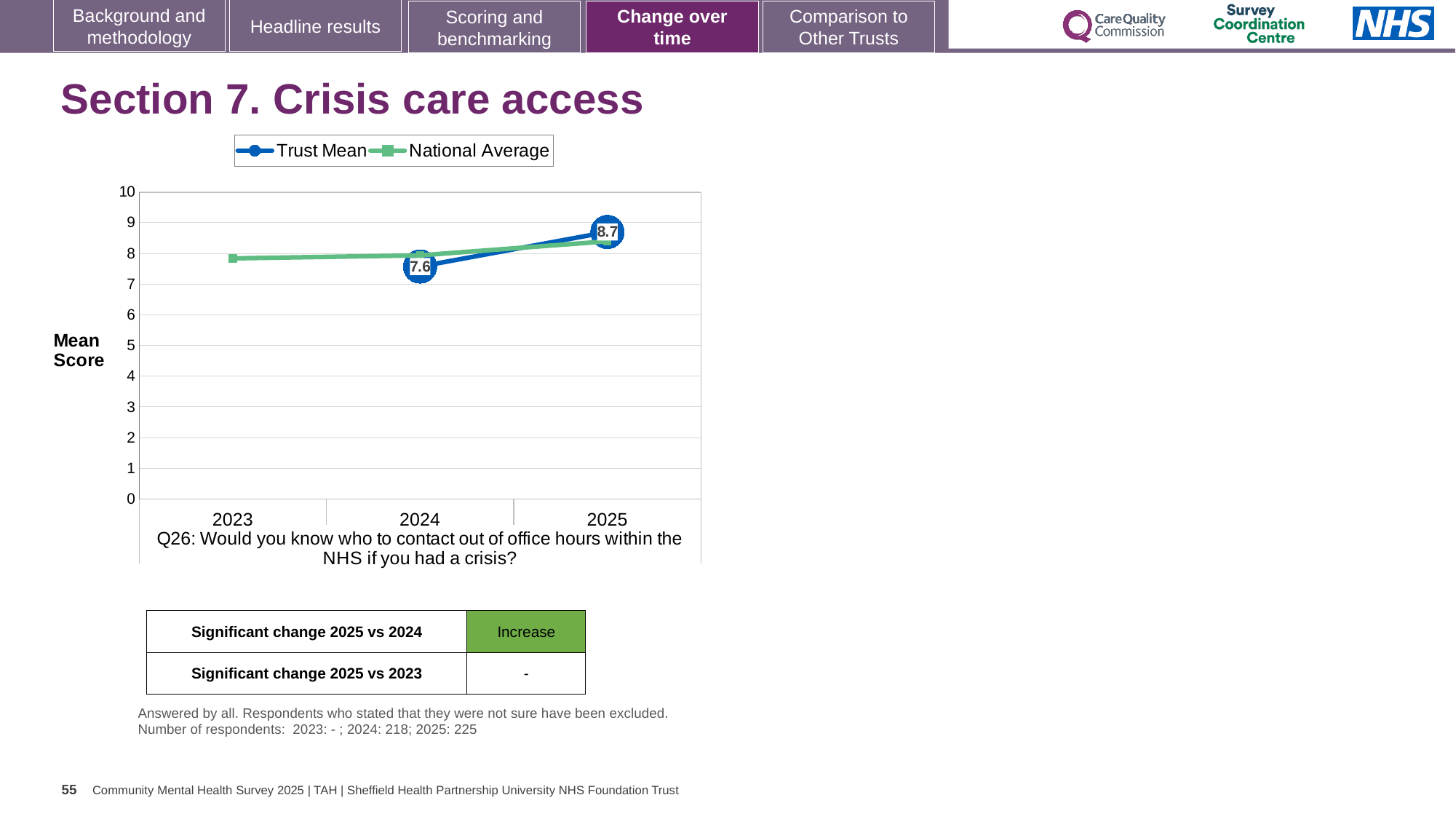
Is the National Average value for 2023 greater or less than 7? greater How many years are shown on the x axis? 3 What kind of chart is shown on the slide? line chart How many series does the legend list? 2 What is the title of the y axis? Mean Score What is the Trust Mean value for 2025? 8.7 In which year is the Trust Mean highest? 2025 Does the Trust Mean rise or fall from 2024 to 2025? rise Is the National Average value for 2025 greater or less than 9? less Which year has the higher Trust Mean, 2024 or 2025? 2025 By how much did the Trust Mean change from 2024 to 2025? 1.1 What is the Trust Mean value for 2024? 7.6